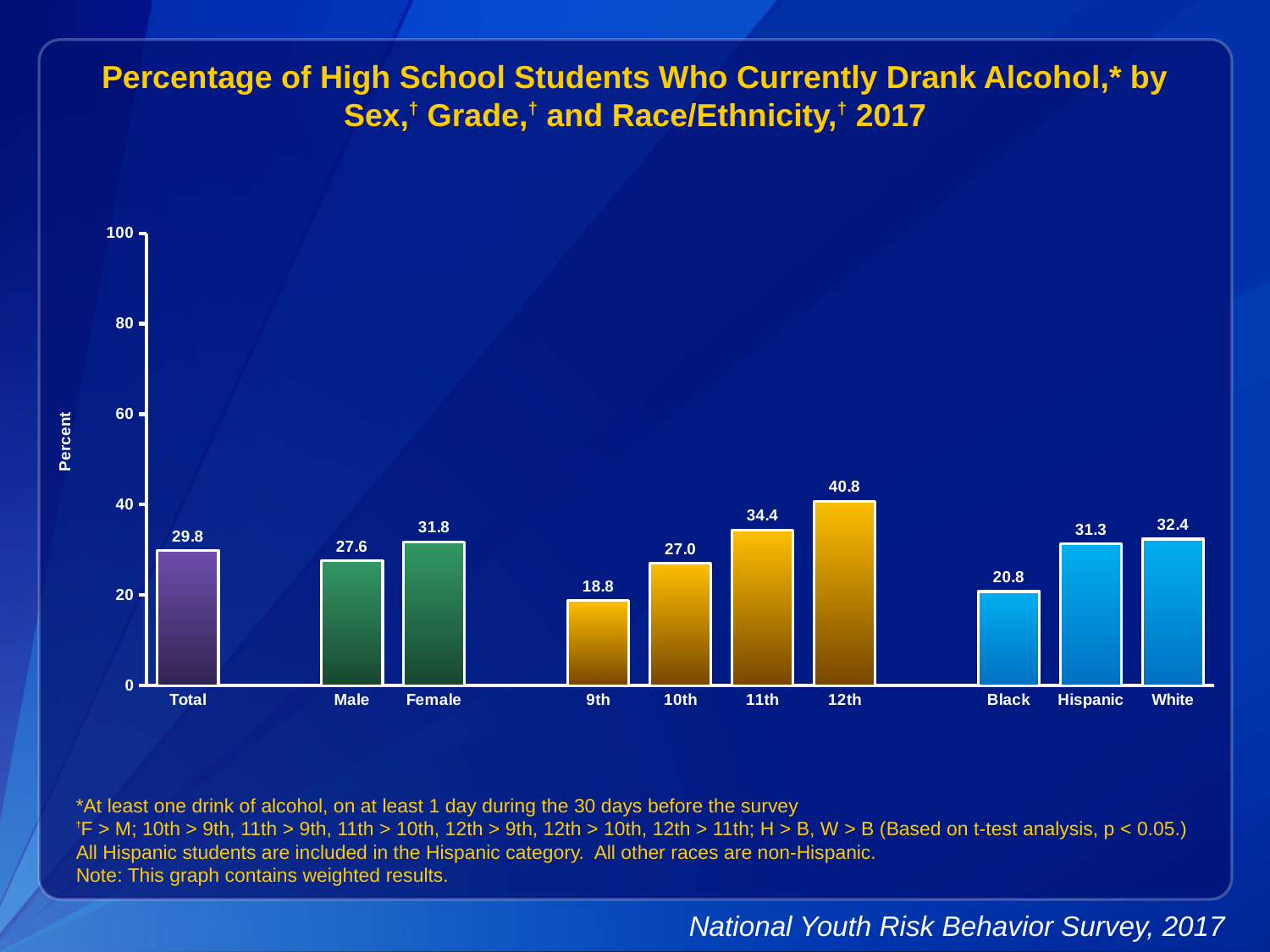
Which category has the lowest value? 9th What is the value for Total? 29.8 What is the difference between the Female and Male values? 4.2 What percentage of 12th grade students currently drank alcohol? 40.8 How many categories are shown on the x axis? 10 What is the value for Black students? 20.8 What kind of chart is this? bar chart Do the values rise or fall from 9th grade to 12th grade? rise What is the label on the y axis? Percent Which category has the highest value? 12th Which is larger, the value for Hispanic or the value for White? White Is the value for 11th grade greater or less than 40? less